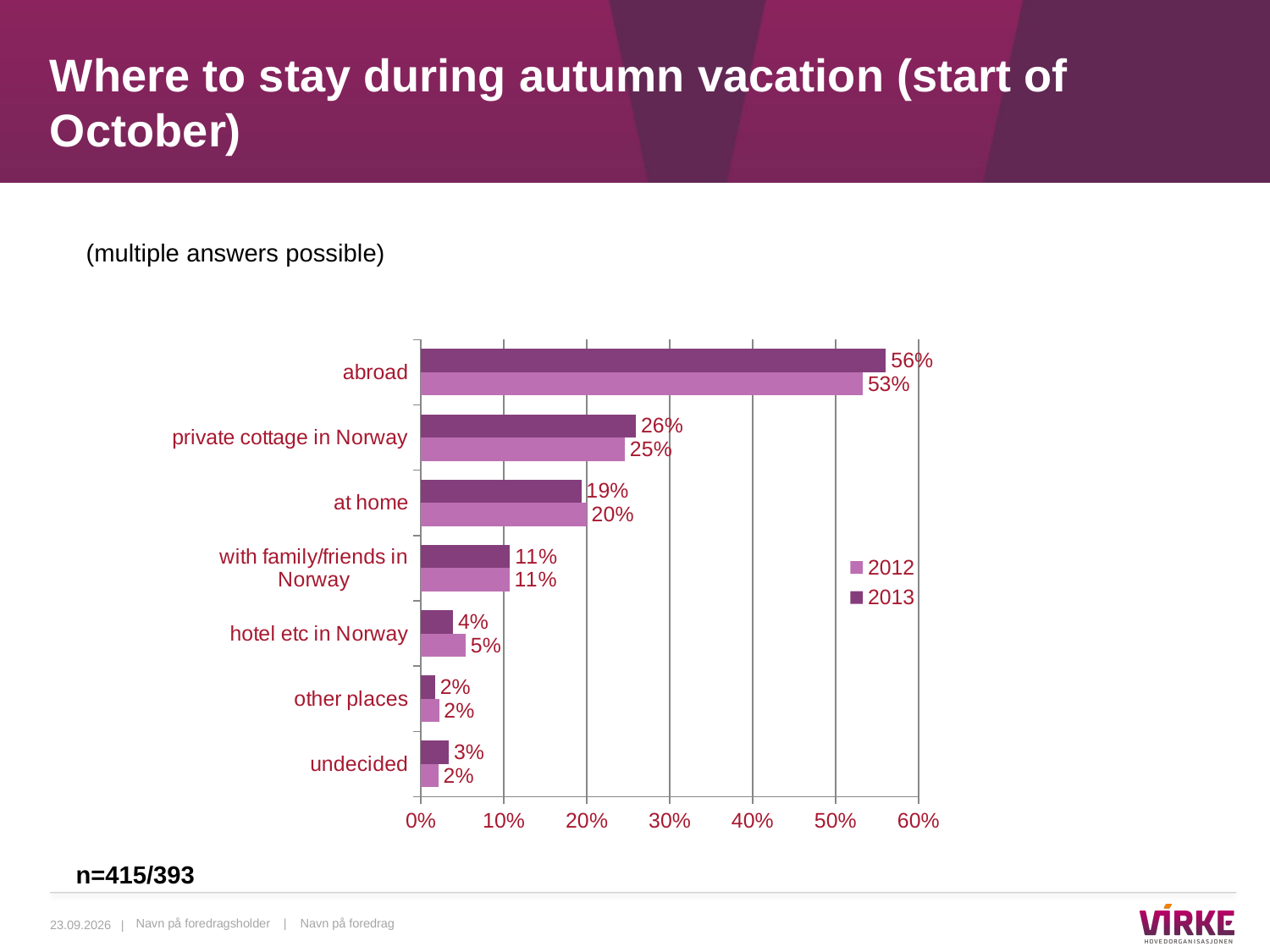
Which category has the highest value for 2013? abroad How many categories are shown on the chart? 7 What is the difference between the 2013 and 2012 values for 'abroad'? 3% What is the 2012 value for 'at home'? 20% Which series is shown in the darker purple colour? 2013 What is the 2013 value for 'abroad'? 56% What is the 2012 value for 'private cottage in Norway'? 25% Which is larger for 'at home': the 2012 value or the 2013 value? 2012 How many series does the legend list? 2 Which category has the lowest value for 2013? other places What kind of chart is shown on the slide? bar chart What is the 2013 value for 'hotel etc in Norway'? 4%